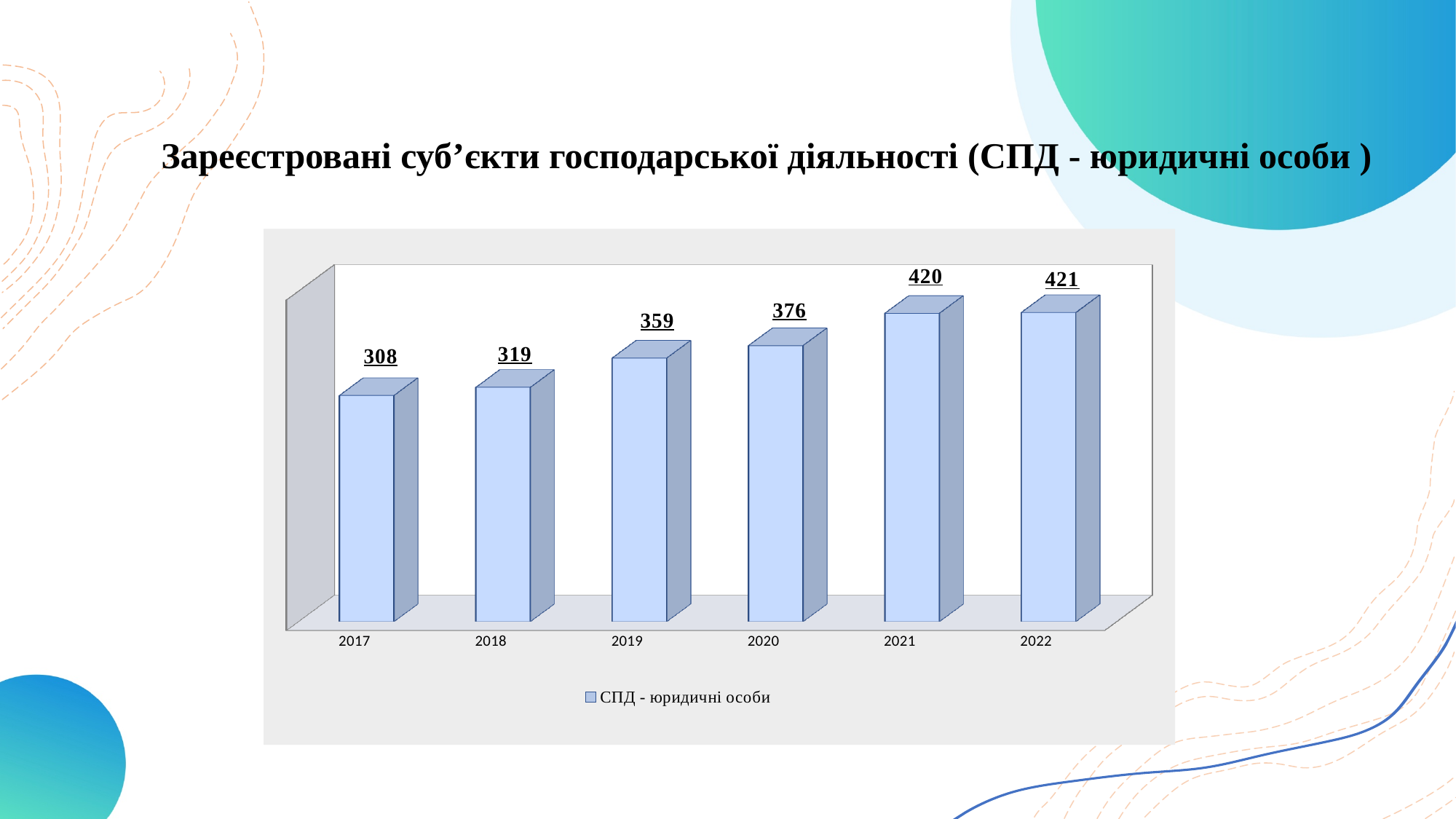
What is the value for 2020? 376 What kind of chart is shown? bar chart What is the value for 2017? 308 Which year has the lowest value? 2017 What is the difference between the values for 2022 and 2017? 113 What is the value for 2022? 421 What is the difference between the values for 2019 and 2018? 40 Do the values rise or fall from 2017 to 2022? rise How many series does the legend list? 1 How many years are shown on the x axis? 6 What is the legend entry for the series? СПД - юридичні особи Which is larger, the value for 2020 or the value for 2019? 2020